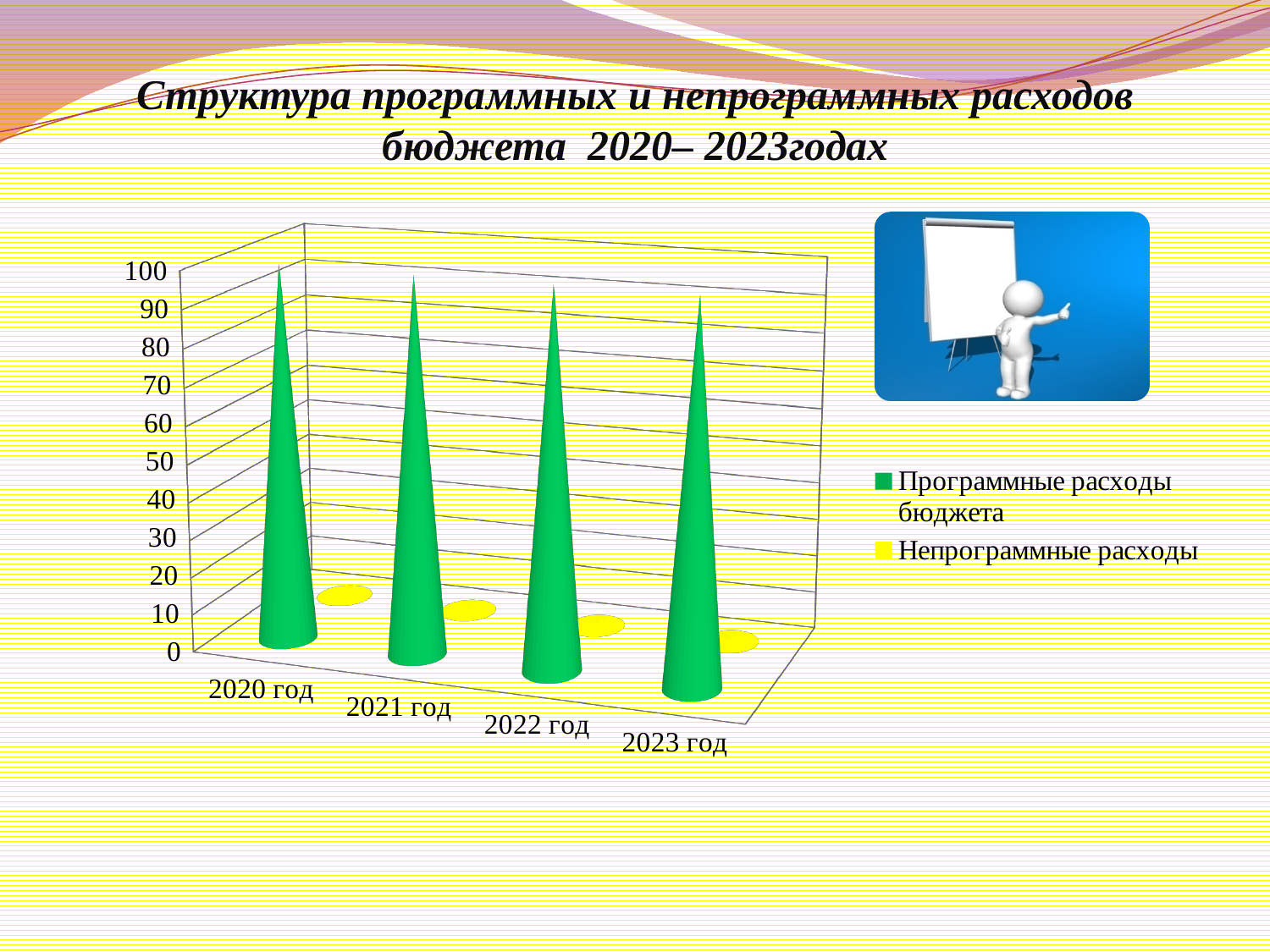
Is the value for Непрограммные расходы in 2020 год greater or less than 10? less What is the highest value shown on the vertical axis? 100 How many series does the legend list? 2 Is the value for Непрограммные расходы in 2023 год greater or less than 20? less How many year categories are shown on the x axis? 4 Which series is shown in green? Программные расходы бюджета In 2021 год, which is larger: Программные расходы бюджета or Непрограммные расходы? Программные расходы бюджета What is the title of the chart on the slide? Структура программных и непрограммных расходов бюджета 2020– 2023годах What kind of chart is shown on the slide? bar chart In 2022 год, which is larger: Непрограммные расходы or Программные расходы бюджета? Программные расходы бюджета Is the value for Программные расходы бюджета in 2020 год greater or less than 90? greater